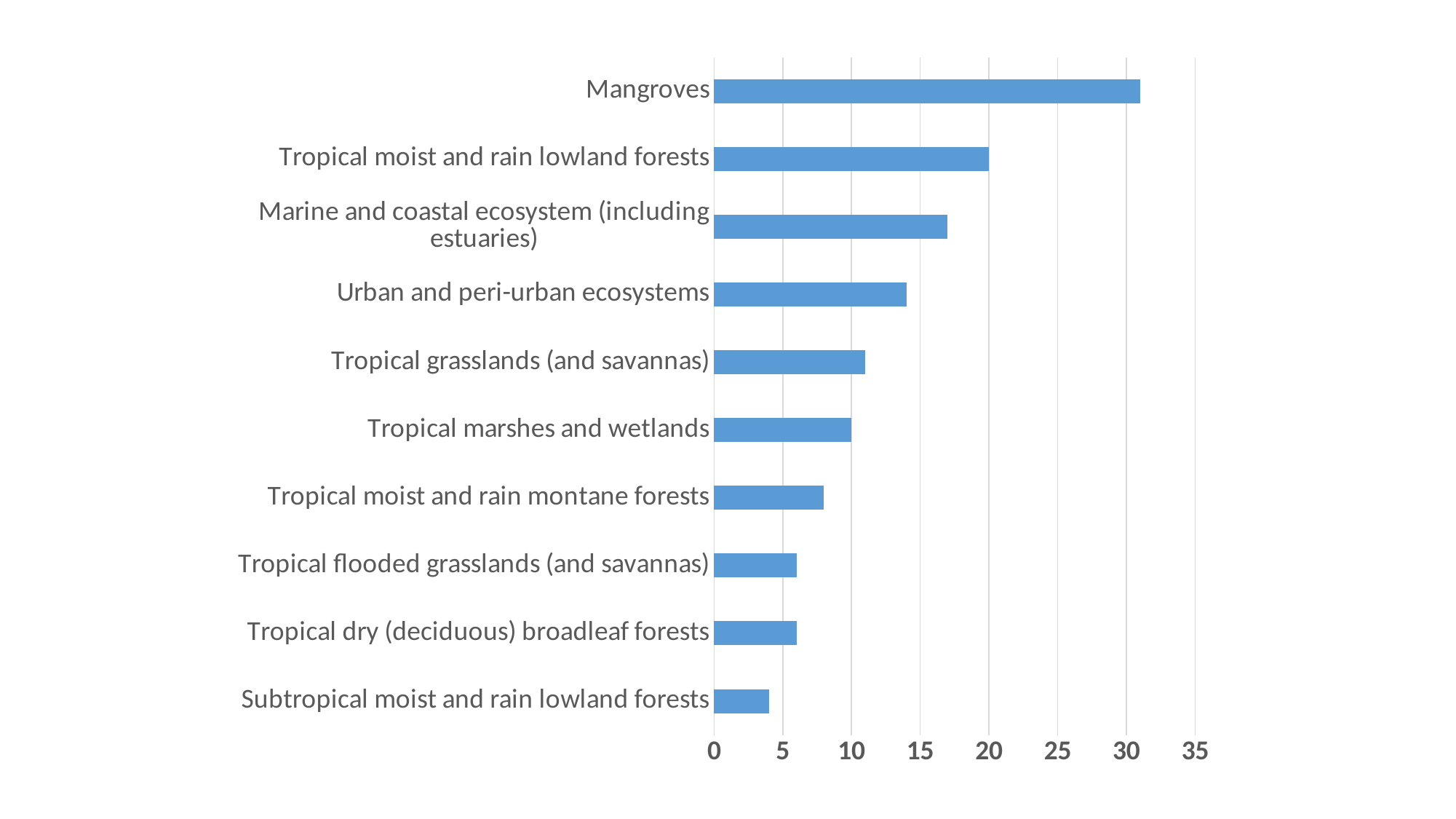
Which category has the lowest value? Subtropical moist and rain lowland forests What is the value for Tropical marshes and wetlands? 10 How many categories are plotted in the chart? 10 Which category has the highest value? Mangroves Is the value for Marine and coastal ecosystem (including estuaries) greater or less than 15? greater Is the value for Urban and peri-urban ecosystems greater or less than 15? less Which is larger, the value for Tropical grasslands (and savannas) or the value for Tropical moist and rain montane forests? Tropical grasslands (and savannas) What is the value for Tropical moist and rain lowland forests? 20 Is the value for Subtropical moist and rain lowland forests greater or less than 5? less What kind of chart is shown on the slide? bar chart Which is larger, the value for Mangroves or the value for Tropical moist and rain lowland forests? Mangroves